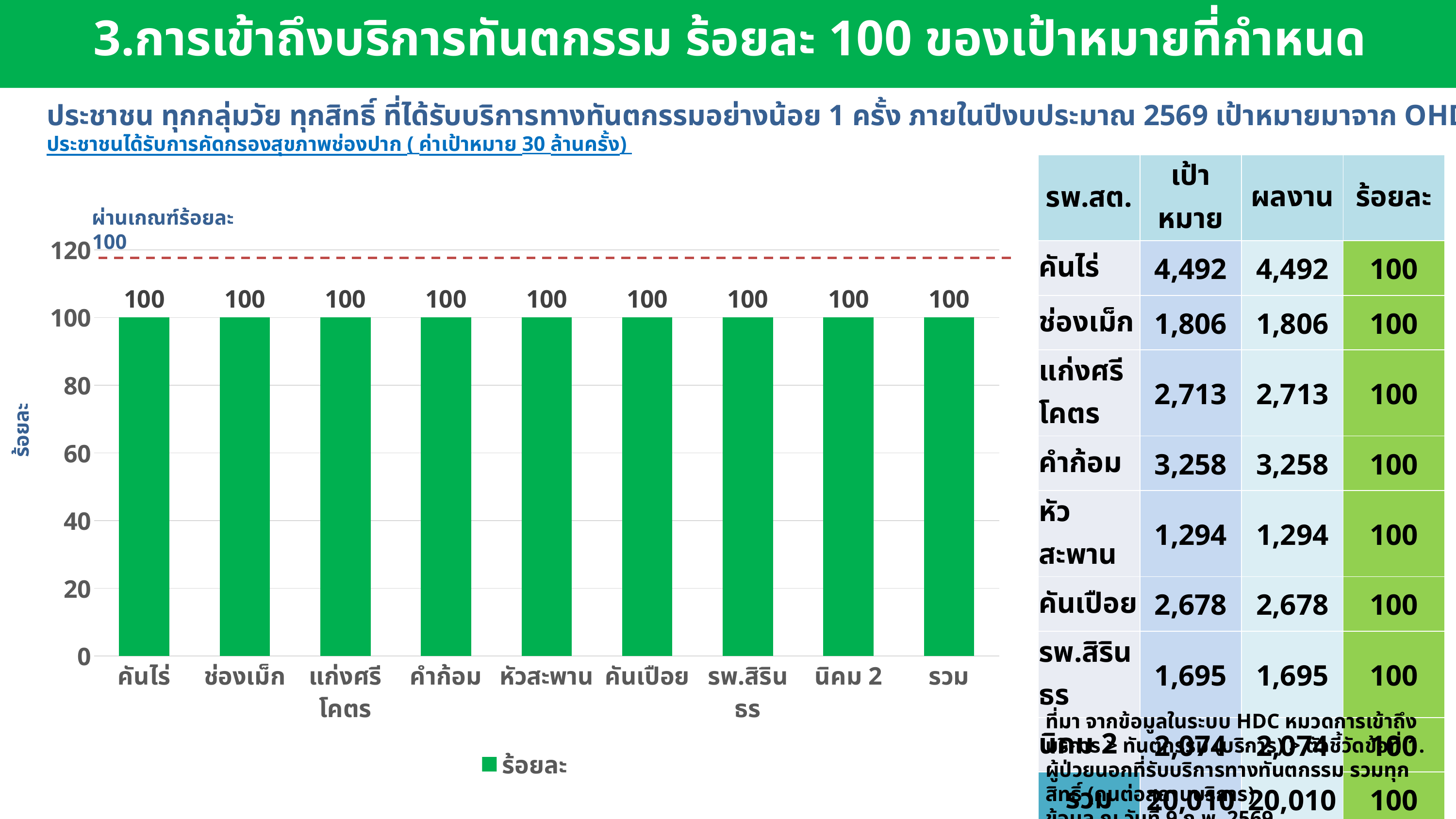
What is the name of the series shown in the chart legend? ร้อยละ What is the value for รวม in the bar chart? 100 What kind of chart is shown on the slide? bar chart Do the values rise, fall, or stay the same across the categories on the x axis? stay the same What is the value for นิคม 2 in the bar chart? 100 How many series does the chart legend list? 1 What is the difference between the values for คำก้อม and หัวสะพาน? 0 Is the value for ช่องเม็ก greater or less than 80? greater What is the value for คันไร่ in the bar chart? 100 What is the highest tick value shown on the y axis of the chart? 120 What is the value for รพ.สิรินธร in the bar chart? 100 How many categories are shown on the x axis of the bar chart? 9